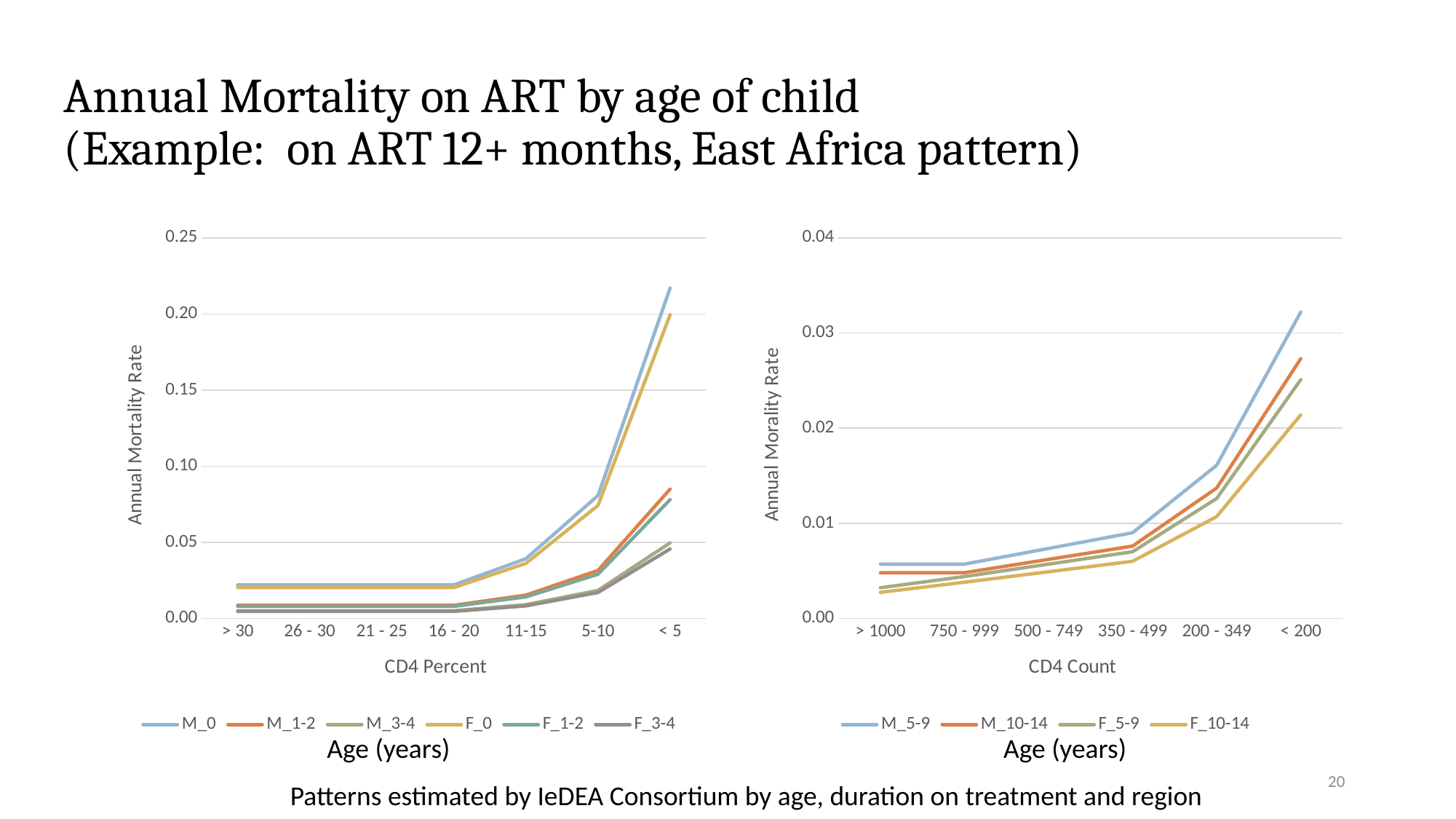
How many CD4 Percent categories are shown on the x axis of the left chart? 7 In the left chart (CD4 Percent), which series has the highest value at the < 5 category? M_0 In the left chart (CD4 Percent), is the value for M_0 at < 5 greater or less than 0.20? greater In the right chart (CD4 Count), which series has the highest value at the < 200 category? M_5-9 How many series does the legend of the right chart (CD4 Count) list? 4 In the right chart (CD4 Count), is the value for M_10-14 at < 200 greater or less than 0.03? less How many CD4 Count categories are shown on the x axis of the right chart? 6 What is the x-axis label of the right chart? CD4 Count What kind of chart is the left chart (CD4 Percent)? Line chart In the right chart (CD4 Count), do the mortality rates rise or fall moving from > 1000 to < 200 along the x axis? Rise How many series does the legend of the left chart (CD4 Percent) list? 6 In the right chart (CD4 Count), which series has the lowest value at the < 200 category? F_10-14